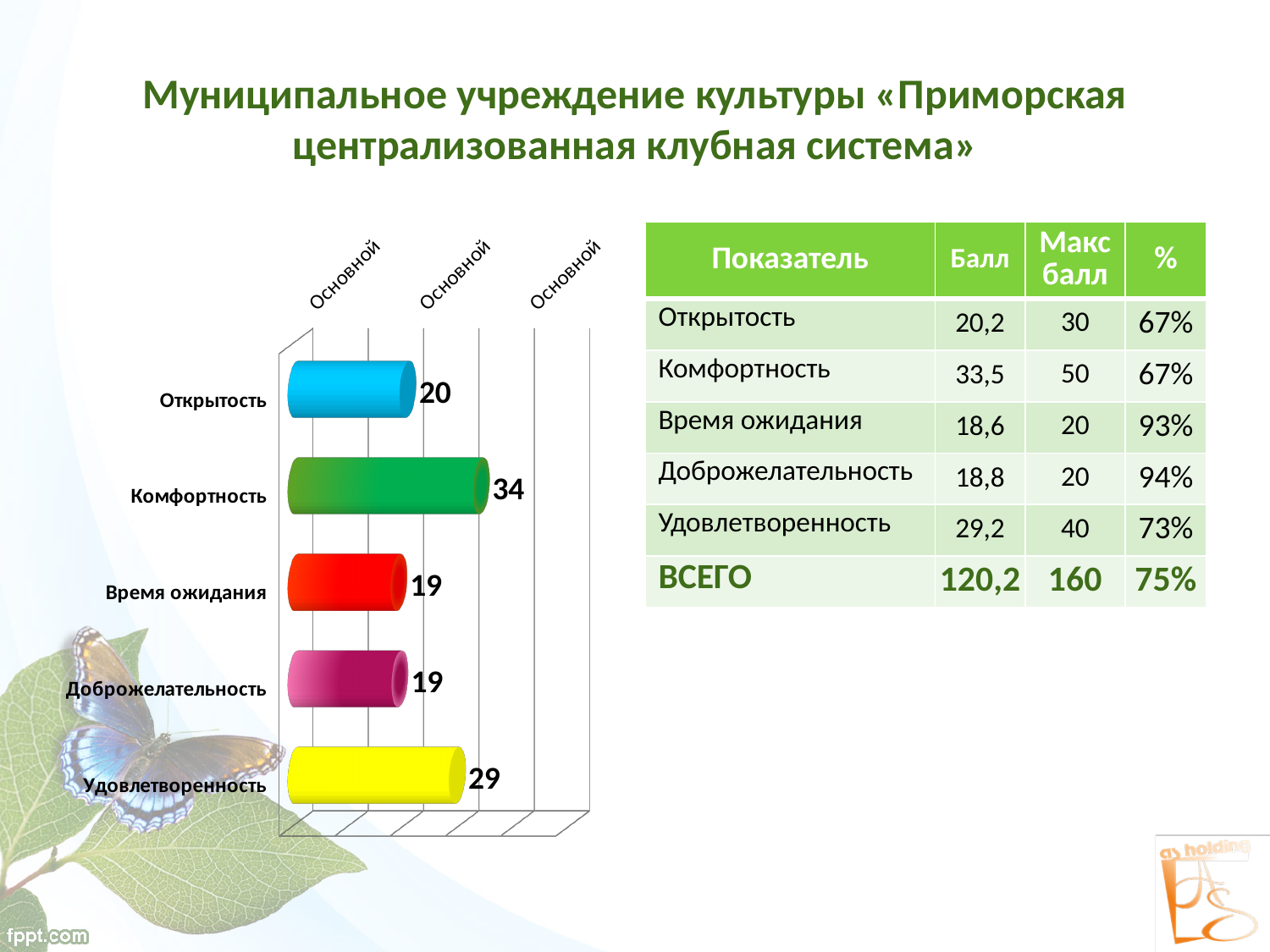
What value is shown for Комфортность in the bar chart? 34 How many categories are plotted in the bar chart? 5 What value is shown for Открытость in the bar chart? 20 What is the difference between the values for Комфортность and Удовлетворенность in the bar chart? 5 What kind of chart is shown on the slide? Bar chart What colour is the bar for Время ожидания in the chart? Red Which category has the highest value in the bar chart? Комфортность What colour is the bar for Удовлетворенность in the chart? Yellow What value is shown for Удовлетворенность in the bar chart? 29 What value is shown for Время ожидания in the bar chart? 19 Which is larger in the bar chart, the value for Удовлетворенность or the value for Открытость? Удовлетворенность What is the difference between the values for Открытость and Доброжелательность in the bar chart? 1